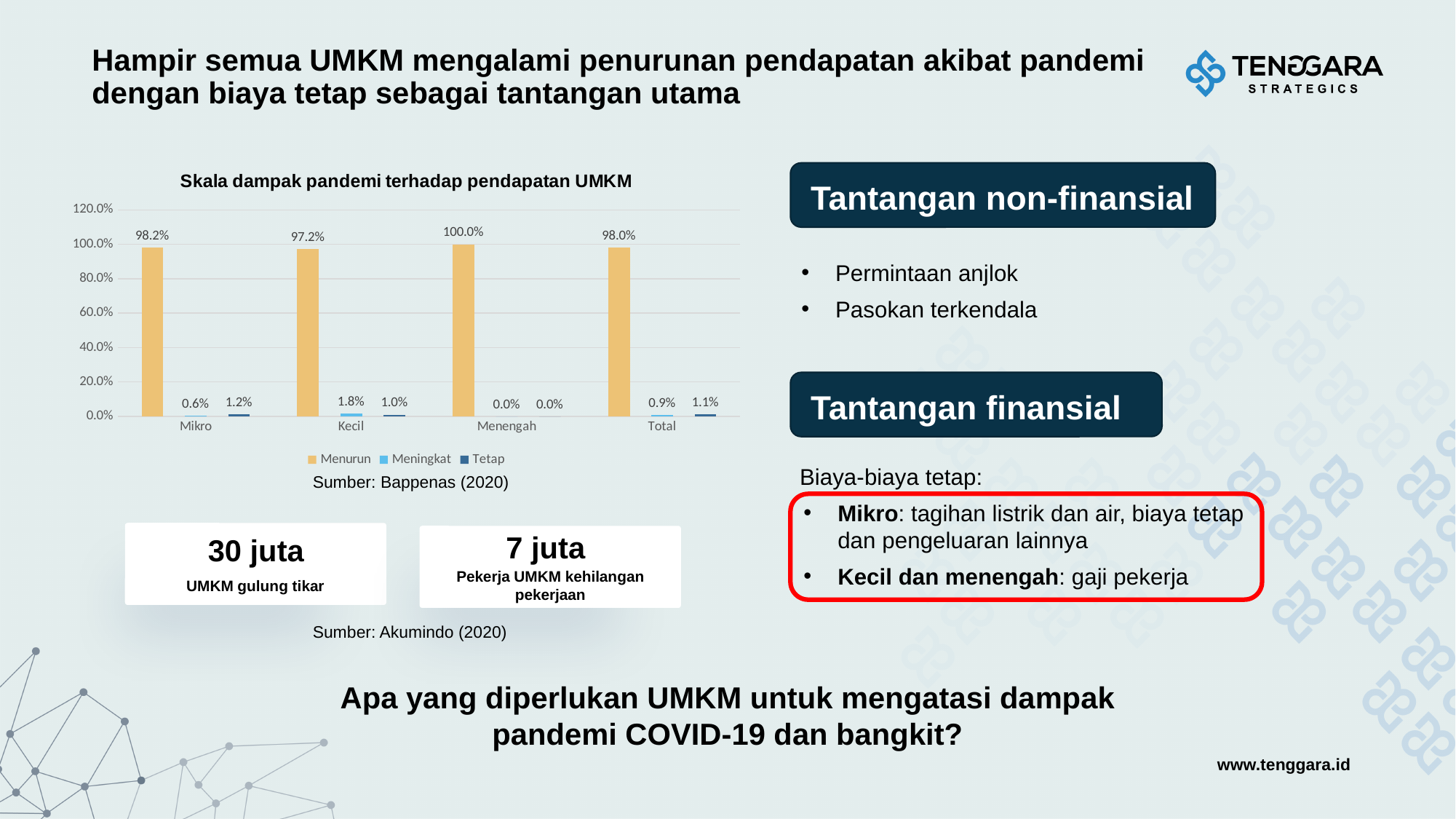
What is the value of Meningkat for Kecil? 1.8% What is the difference between the Menurun values for Mikro and Kecil? 1.0% What is the value of Tetap for Total? 1.1% Which is larger for Mikro: Meningkat or Tetap? Tetap How many series does the legend list? 3 What is the value of Menurun for Mikro? 98.2% Which category has the highest Menurun value? Menengah What kind of chart is shown? bar chart How many categories are shown on the x axis? 4 What is the value of Menurun for Menengah? 100.0% Which category has the lowest Menurun value? Kecil What is the title of the chart? Skala dampak pandemi terhadap pendapatan UMKM